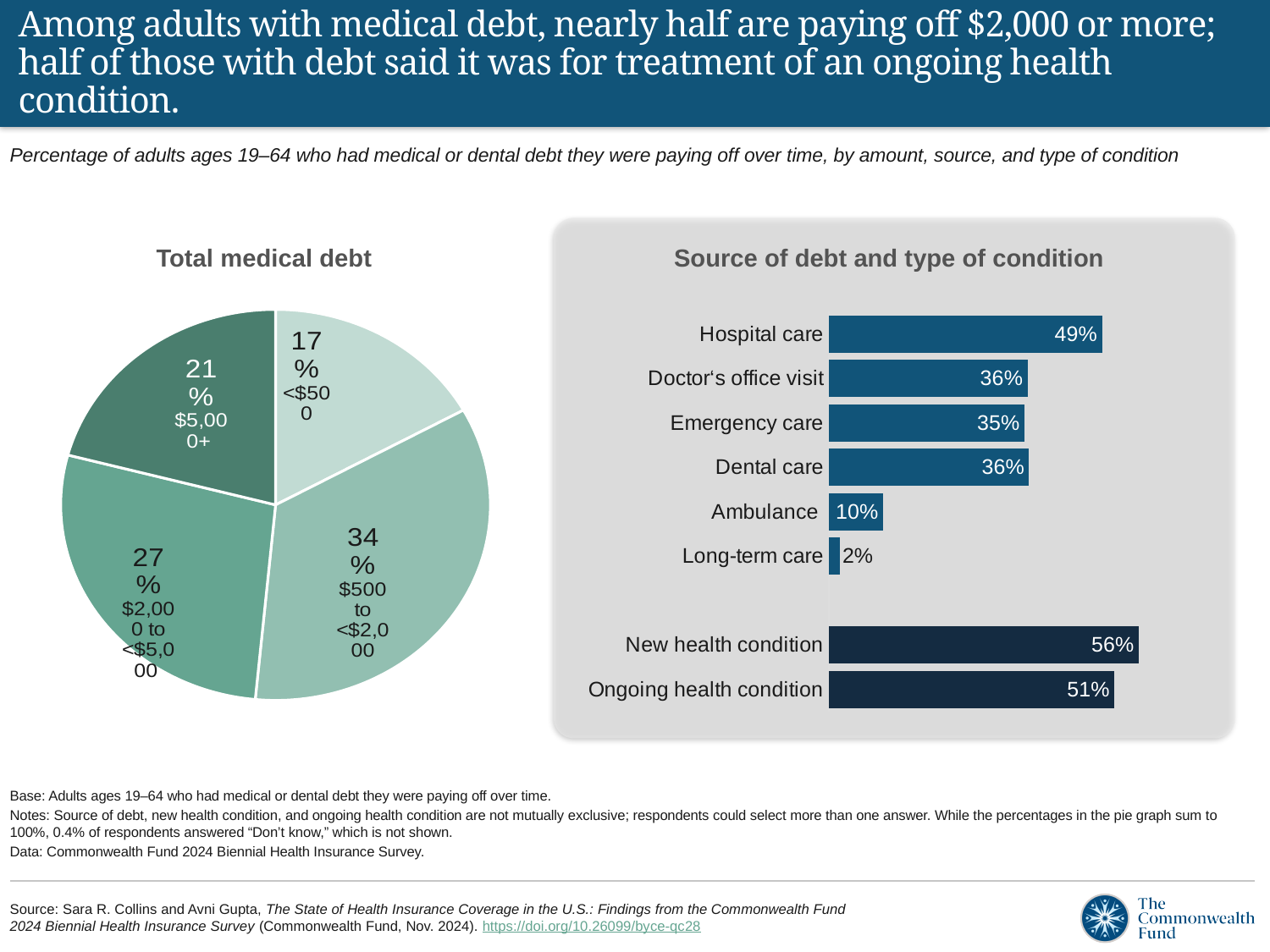
What kind of chart is 'Source of debt and type of condition'? Bar chart In the 'Source of debt and type of condition' chart, what is the value for Ambulance? 10% In the 'Total medical debt' pie chart, what percentage of adults had debt of $5,000+? 21% In the 'Source of debt and type of condition' chart, what is the value for Hospital care? 49% In the 'Source of debt and type of condition' chart, which is larger: Hospital care or Emergency care? Hospital care In the 'Total medical debt' pie chart, what percentage of adults had debt of $500 to <$2,000? 34% What kind of chart is 'Total medical debt'? Pie chart In the 'Source of debt and type of condition' chart, what is the difference between New health condition and Ongoing health condition? 5 percentage points In the 'Total medical debt' pie chart, which debt amount category has the smallest share? <$500 In the 'Total medical debt' pie chart, which debt amount category has the largest share? $500 to <$2,000 In the 'Source of debt and type of condition' chart, which category has the lowest value? Long-term care In the 'Total medical debt' pie chart, how many slices are there? 4